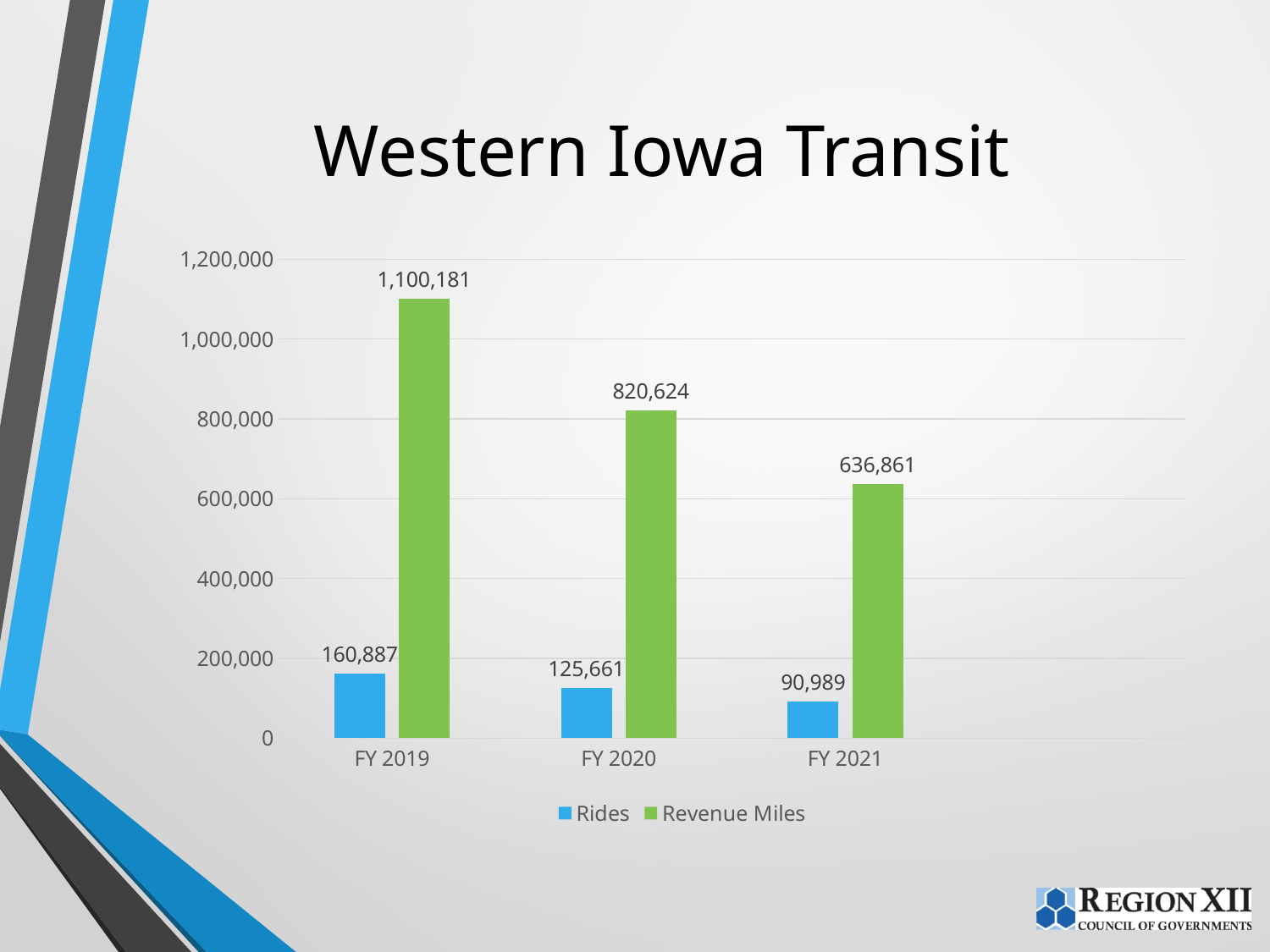
What is the difference in Rides between FY 2019 and FY 2021? 69,898 Which is larger: Rides in FY 2020 or Rides in FY 2021? Rides in FY 2020 How many series does the legend list? 2 What is the difference in Revenue Miles between FY 2019 and FY 2020? 279,557 What is the value of Revenue Miles for FY 2020? 820,624 How many fiscal years are shown on the x axis? 3 What is the value of Rides for FY 2019? 160,887 What is the value of Rides for FY 2021? 90,989 What is the value of Revenue Miles for FY 2021? 636,861 Which fiscal year has the highest Revenue Miles? FY 2019 Which fiscal year has the lowest Rides? FY 2021 Do Revenue Miles rise or fall from FY 2019 to FY 2021? fall